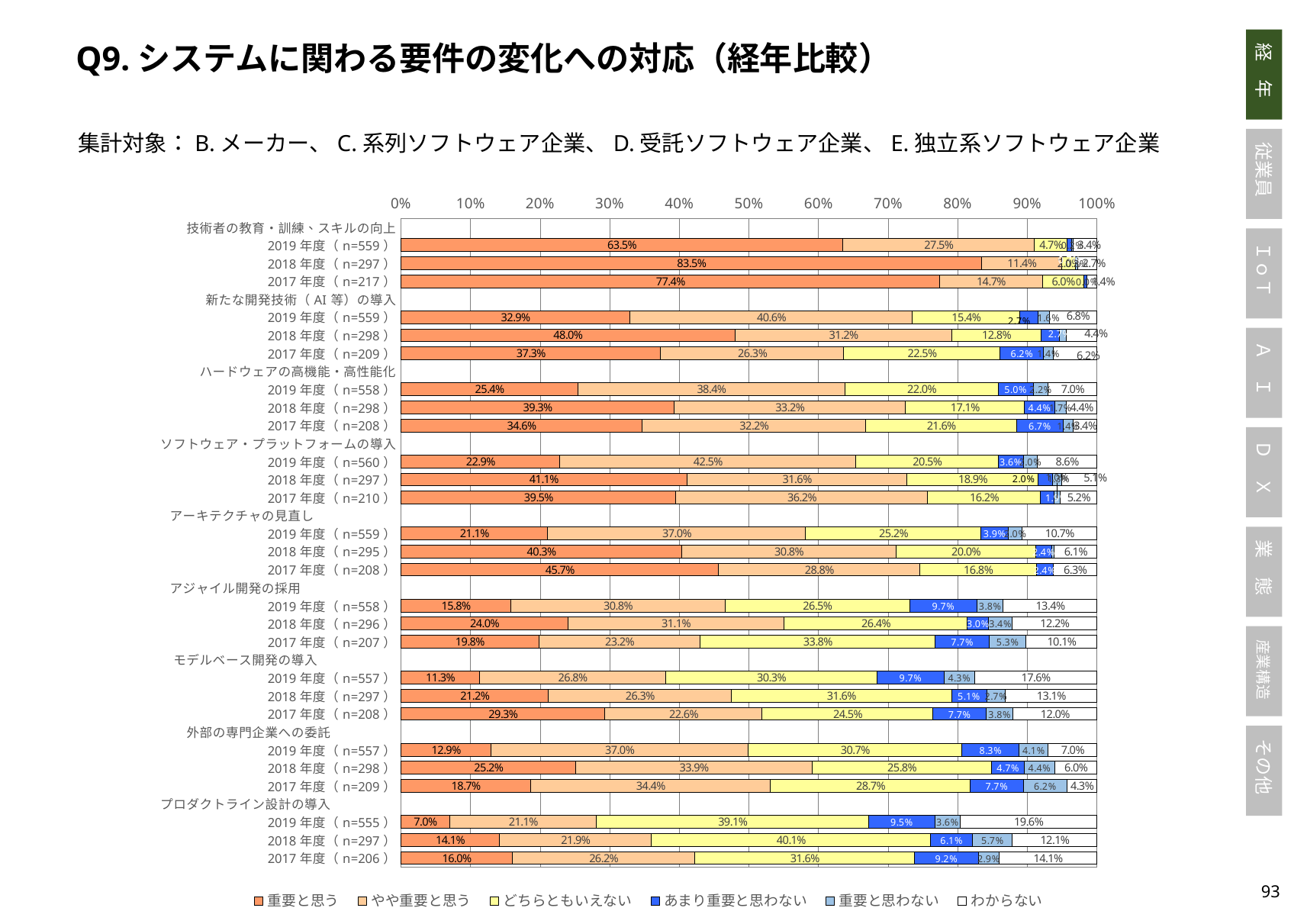
What is the どちらともいえない value for プロダクトライン設計の導入 in 2018年度 (n=297)? 40.1% What is the わからない value for モデルベース開発の導入 in 2019年度 (n=557)? 17.6% What is the first legend entry of the chart? 重要と思う How many topic categories (excluding the year rows) are listed on the chart? 9 What kind of chart is shown on the slide? stacked bar chart Which row has the highest 重要と思う value? 技術者の教育・訓練、スキルの向上 2018年度 (n=297) Which is larger: the 重要と思う value for アジャイル開発の採用 in 2018年度 (n=296) or in 2019年度 (n=558)? 2018年度 (n=296) Which row has the lowest 重要と思う value? プロダクトライン設計の導入 2019年度 (n=555) What is the difference between the 重要と思う values for アーキテクチャの見直し in 2017年度 (n=208) and 2019年度 (n=559)? 24.6% How many series does the legend list? 6 What is the やや重要と思う value for 新たな開発技術（AI等）の導入 in 2019年度 (n=559)? 40.6% What is the 重要と思う value for 技術者の教育・訓練、スキルの向上 in 2018年度 (n=297)? 83.5%